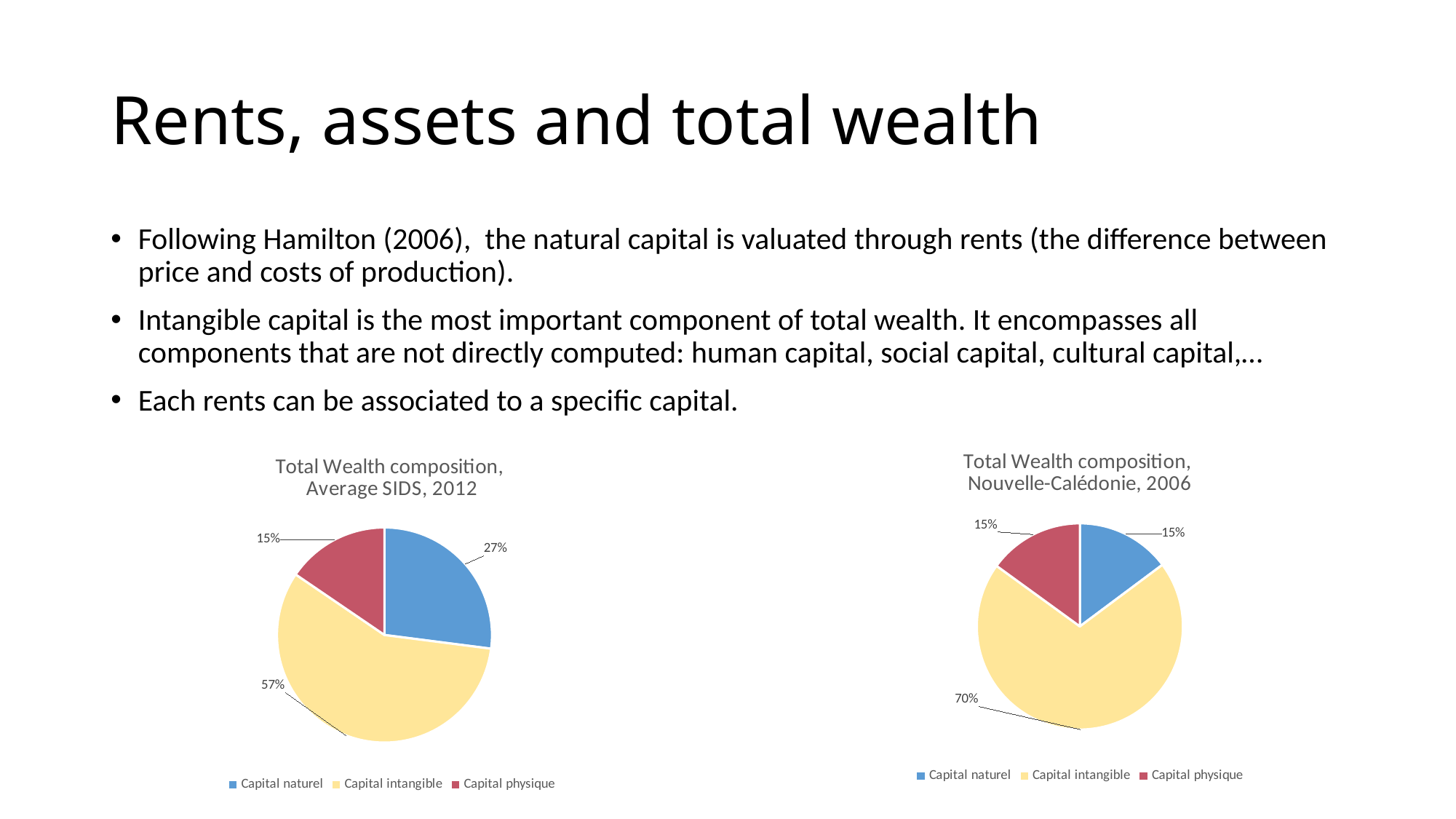
In the 'Total Wealth composition, Average SIDS, 2012' chart, what is the difference between the Capital intangible share and the Capital naturel share? 30 percentage points How many categories does the legend of the 'Total Wealth composition, Average SIDS, 2012' chart list? 3 In the 'Total Wealth composition, Nouvelle-Calédonie, 2006' chart, what share does Capital naturel have? 15% In the 'Total Wealth composition, Nouvelle-Calédonie, 2006' chart, what share does Capital intangible have? 70% In the 'Total Wealth composition, Average SIDS, 2012' chart, which category has the largest slice? Capital intangible In the 'Total Wealth composition, Average SIDS, 2012' chart, what share does Capital naturel have? 27% In the 'Total Wealth composition, Average SIDS, 2012' chart, which category has the smallest slice? Capital physique In the 'Total Wealth composition, Nouvelle-Calédonie, 2006' chart, which category has the largest slice? Capital intangible What type of chart is the 'Total Wealth composition, Nouvelle-Calédonie, 2006' chart? Pie chart In the 'Total Wealth composition, Average SIDS, 2012' chart, which is larger, Capital naturel or Capital physique? Capital naturel